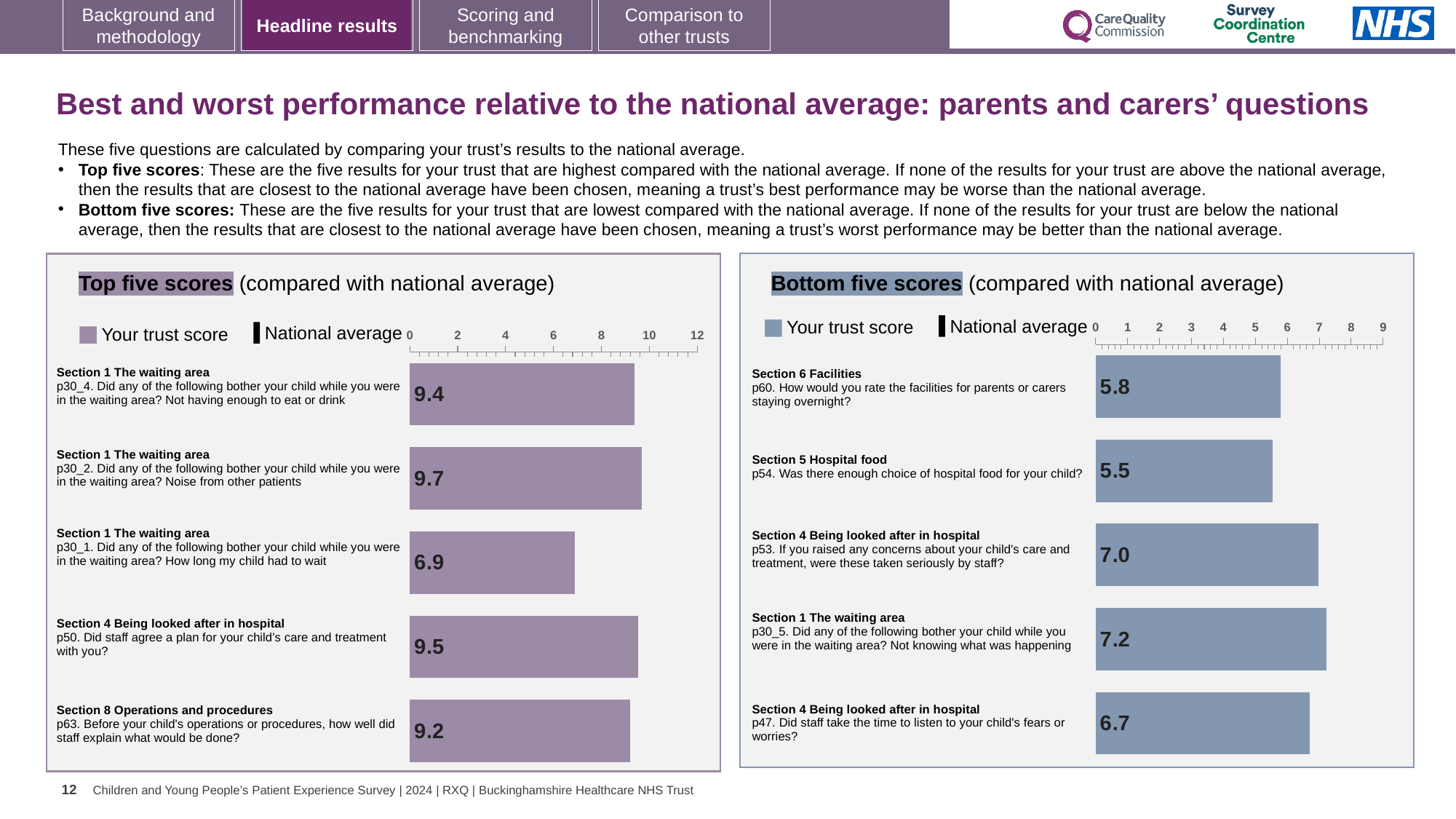
In the Top five scores chart, what is the difference between the trust scores for p30_4 (not having enough to eat or drink) and p30_1 (how long my child had to wait)? 2.5 In the Top five scores chart, what is the trust score for p63 (how well staff explained what would be done before operations or procedures)? 9.2 In the Bottom five scores chart, which question has the highest trust score? p30_5. Not knowing what was happening In the Bottom five scores chart, what is the trust score for p47 (did staff take the time to listen to your child's fears or worries)? 6.7 In the Bottom five scores chart, which has the larger trust score: p53 (concerns taken seriously by staff) or p54 (choice of hospital food)? p53 In the Bottom five scores chart, which question has the lowest trust score? p54. Was there enough choice of hospital food for your child? What type of chart is used in the Top five scores panel? Bar chart How many questions are shown in the Bottom five scores chart? 5 In the Top five scores chart, which question has the lowest trust score? p30_1. How long my child had to wait In the Top five scores chart, which question has the highest trust score? p30_2. Noise from other patients In the Top five scores chart, what is the trust score for p30_2 (noise from other patients in the waiting area)? 9.7 In the Bottom five scores chart, what is the trust score for p60 (facilities for parents or carers staying overnight)? 5.8